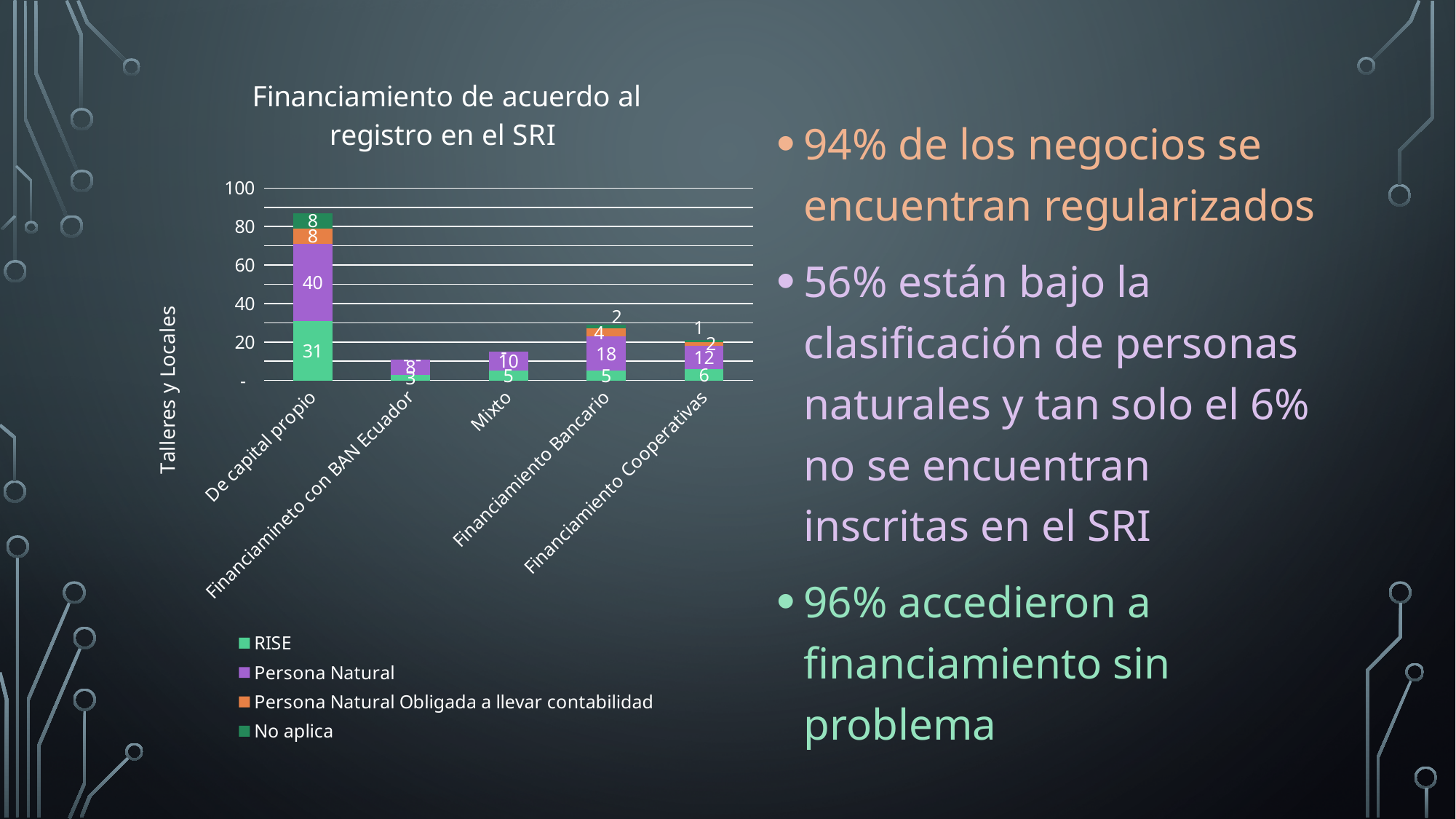
What is the title of the chart? Financiamiento de acuerdo al registro en el SRI What is the Persona Natural value for 'Financiamiento Bancario'? 18 How many series does the legend list? 4 What is the RISE value for 'De capital propio'? 31 What is the total of the stacked bar for 'De capital propio'? 87 How many financing categories are shown on the x axis? 5 What is the RISE value for 'Financiamiento Cooperativas'? 6 Which financing category has the tallest stacked bar? De capital propio Which is larger: the Persona Natural value for 'Financiamiento Bancario' or for 'Financiamiento Cooperativas'? Financiamiento Bancario What is the Persona Natural value for 'De capital propio'? 40 What is the difference between the Persona Natural and RISE values for 'De capital propio'? 9 What type of chart is shown on the slide? Stacked bar chart